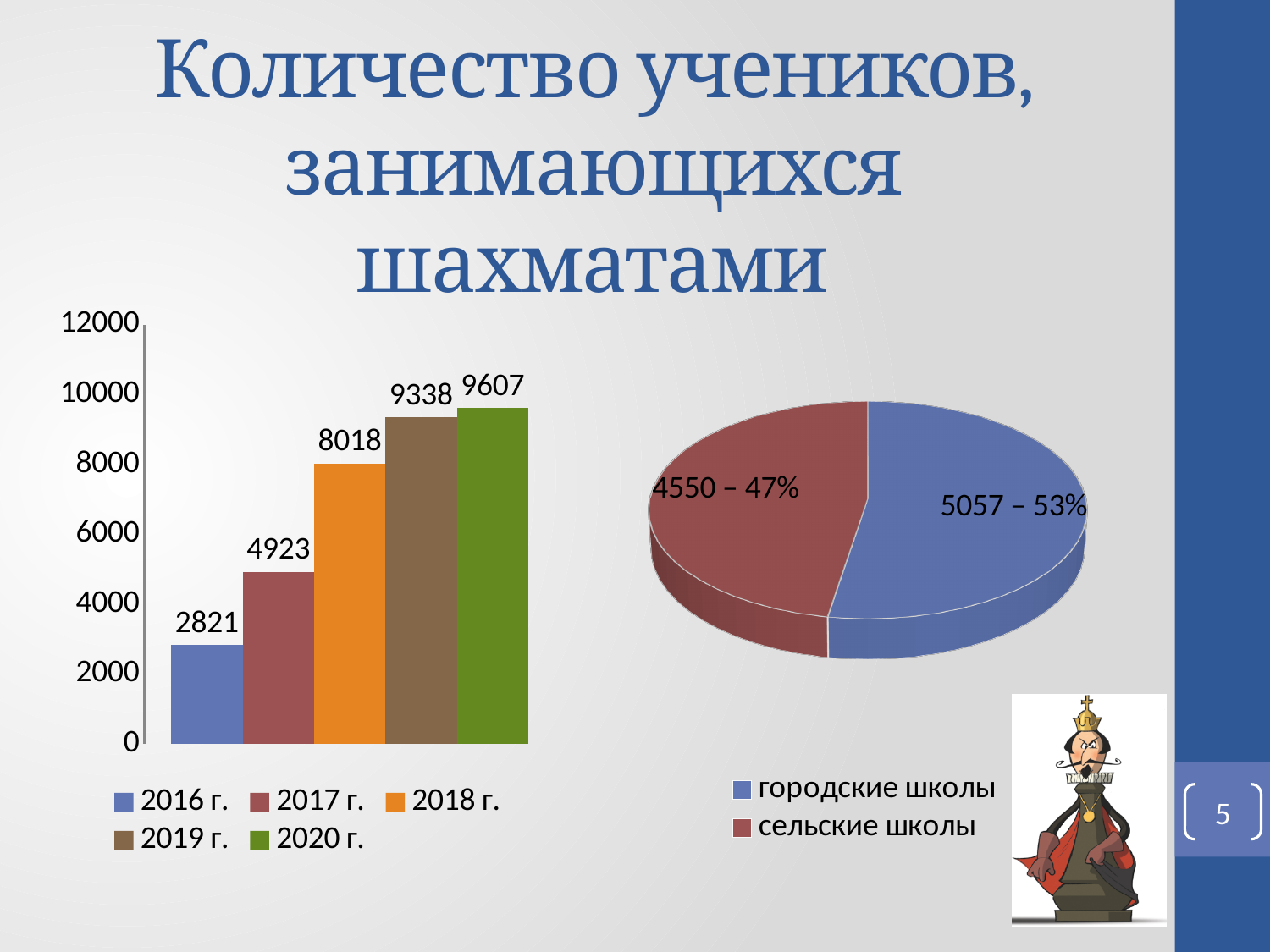
In the bar chart on the left, how many bars are plotted? 5 What kind of chart is shown on the left of the slide? bar chart In the bar chart on the left, which is larger: the value for 2017 г. or the value for 2018 г.? 2018 г. In the bar chart on the left, what is the value for 2018 г.? 8018 In the bar chart on the left, what is the value for 2016 г.? 2821 In the bar chart on the left, what is the difference between the values for 2020 г. and 2019 г.? 269 How many entries does the legend of the pie chart on the right list? 2 In the pie chart on the right, what share of the pie do городские школы have? 53% In the bar chart on the left, which year has the highest value? 2020 г. In the pie chart on the right, what is the value for сельские школы? 4550 In the bar chart on the left, do the values rise or fall from 2016 г. to 2020 г.? rise In the bar chart on the left, which year has the lowest value? 2016 г.